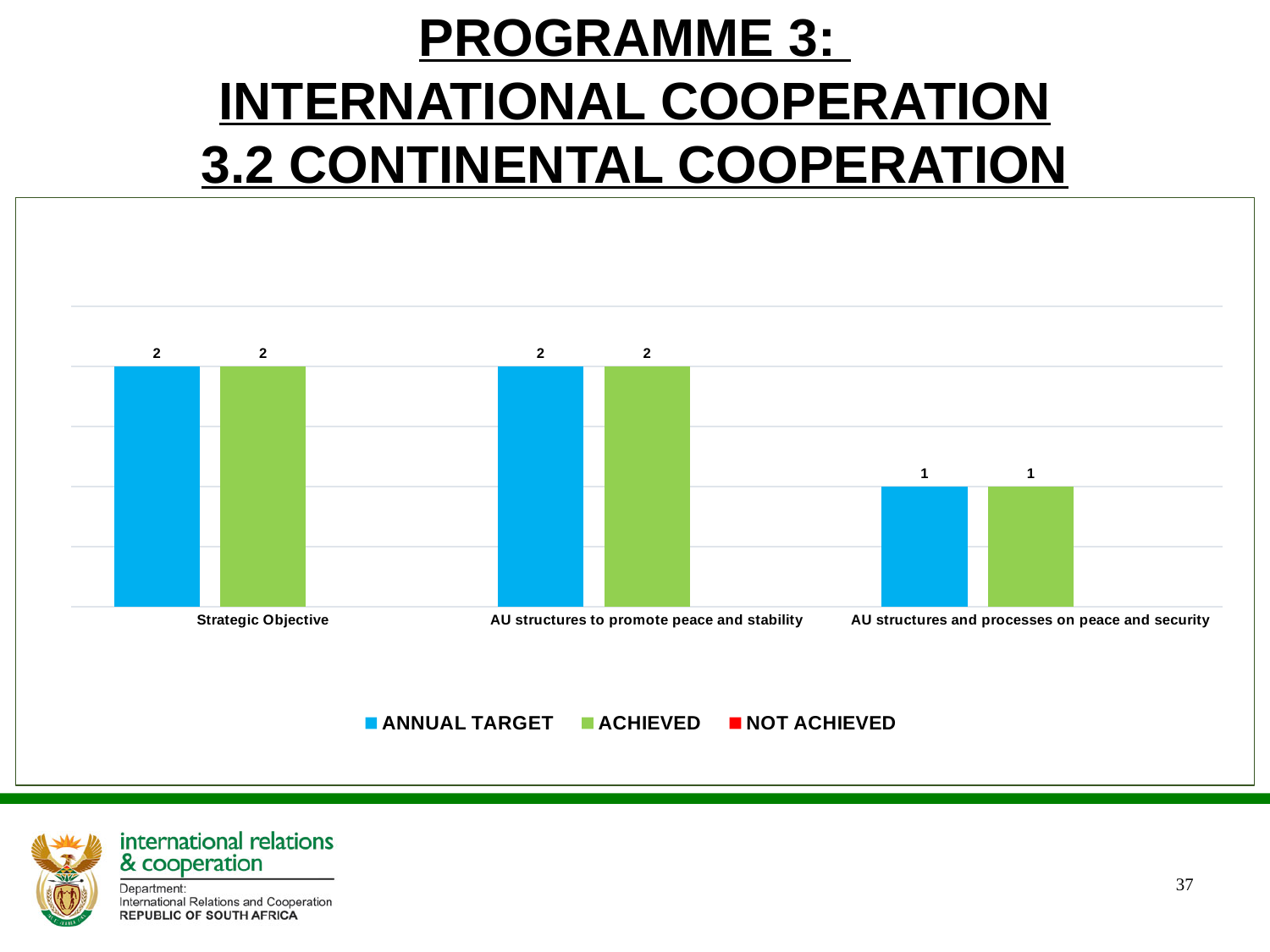
How many categories are shown on the x axis? 3 What colour are the ACHIEVED bars? green What kind of chart is shown on the slide? bar chart What is the ANNUAL TARGET value for AU structures to promote peace and stability? 2 What is the difference between the ACHIEVED value for Strategic Objective and the ACHIEVED value for AU structures and processes on peace and security? 1 Which is larger: the ACHIEVED value for Strategic Objective or the ACHIEVED value for AU structures and processes on peace and security? Strategic Objective What is the ANNUAL TARGET value for Strategic Objective? 2 What is the ACHIEVED value for AU structures and processes on peace and security? 1 Which legend series has no visible bars in the chart? NOT ACHIEVED How many series does the legend list? 3 What is the difference between the ANNUAL TARGET and ACHIEVED values for AU structures to promote peace and stability? 0 Which category has the lowest ANNUAL TARGET value? AU structures and processes on peace and security